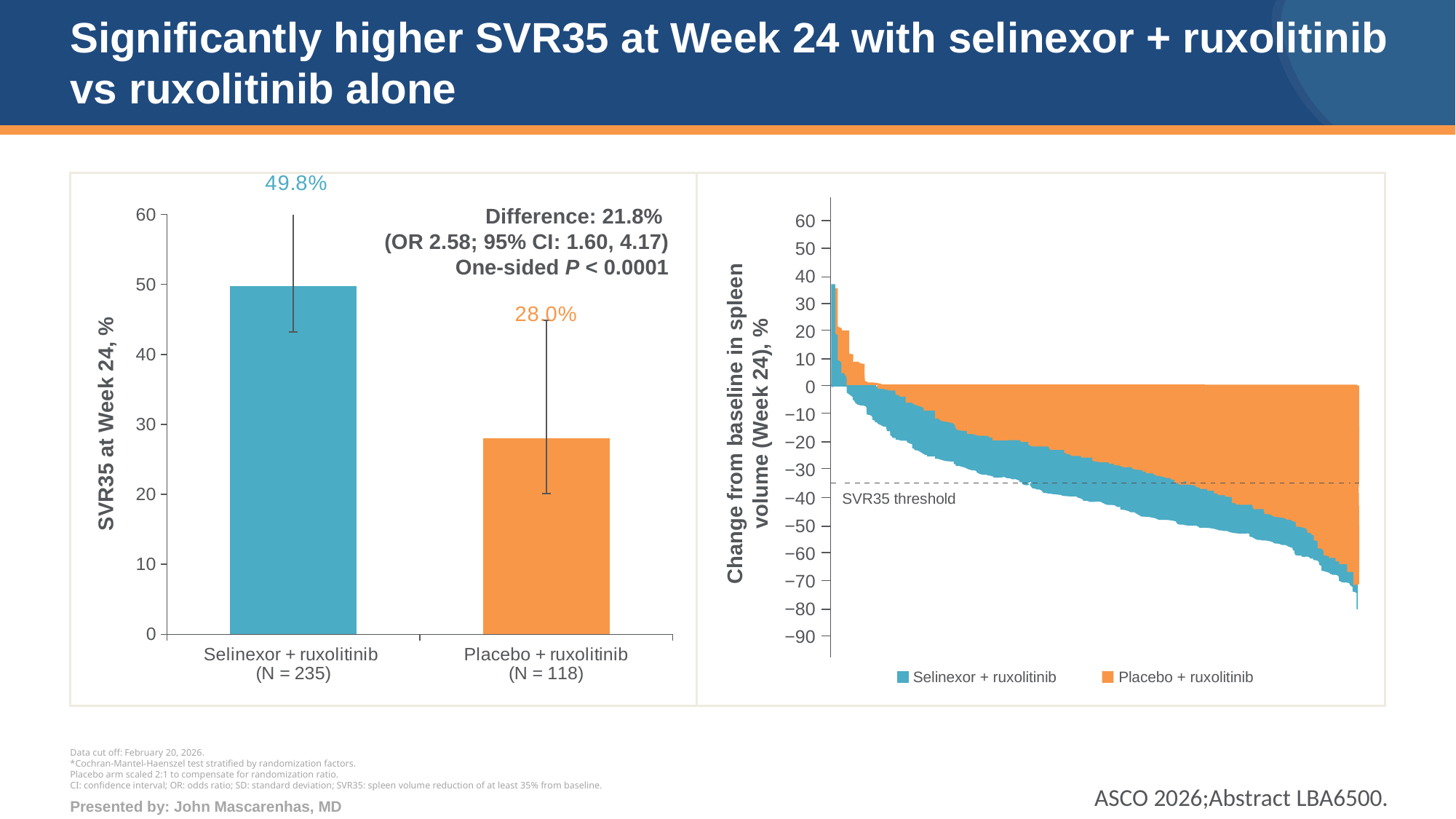
On the left chart (SVR35 at Week 24), what is the number of patients in the Selinexor + ruxolitinib arm? N = 235 On the right chart (Change from baseline in spleen volume), do the plotted values rise or fall from left to right along the x axis? Fall On the left chart (SVR35 at Week 24), which treatment arm has the higher SVR35 rate? Selinexor + ruxolitinib On the left chart (SVR35 at Week 24), what is the difference between the SVR35 rates of the two arms? 21.8% On the right chart (Change from baseline in spleen volume), which colour represents Placebo + ruxolitinib? Orange What kind of chart is the left chart (SVR35 at Week 24)? Bar chart On the left chart (SVR35 at Week 24), how many treatment arms are plotted? 2 On the right chart (Change from baseline in spleen volume), how many series does the legend list? 2 On the left chart (SVR35 at Week 24), what is the SVR35 rate for Selinexor + ruxolitinib? 49.8% On the left chart (SVR35 at Week 24), what is the SVR35 rate for Placebo + ruxolitinib? 28.0% On the left chart (SVR35 at Week 24), is the value for Placebo + ruxolitinib greater or less than 30? less On the right chart (Change from baseline in spleen volume), what is the dashed horizontal line labelled? SVR35 threshold